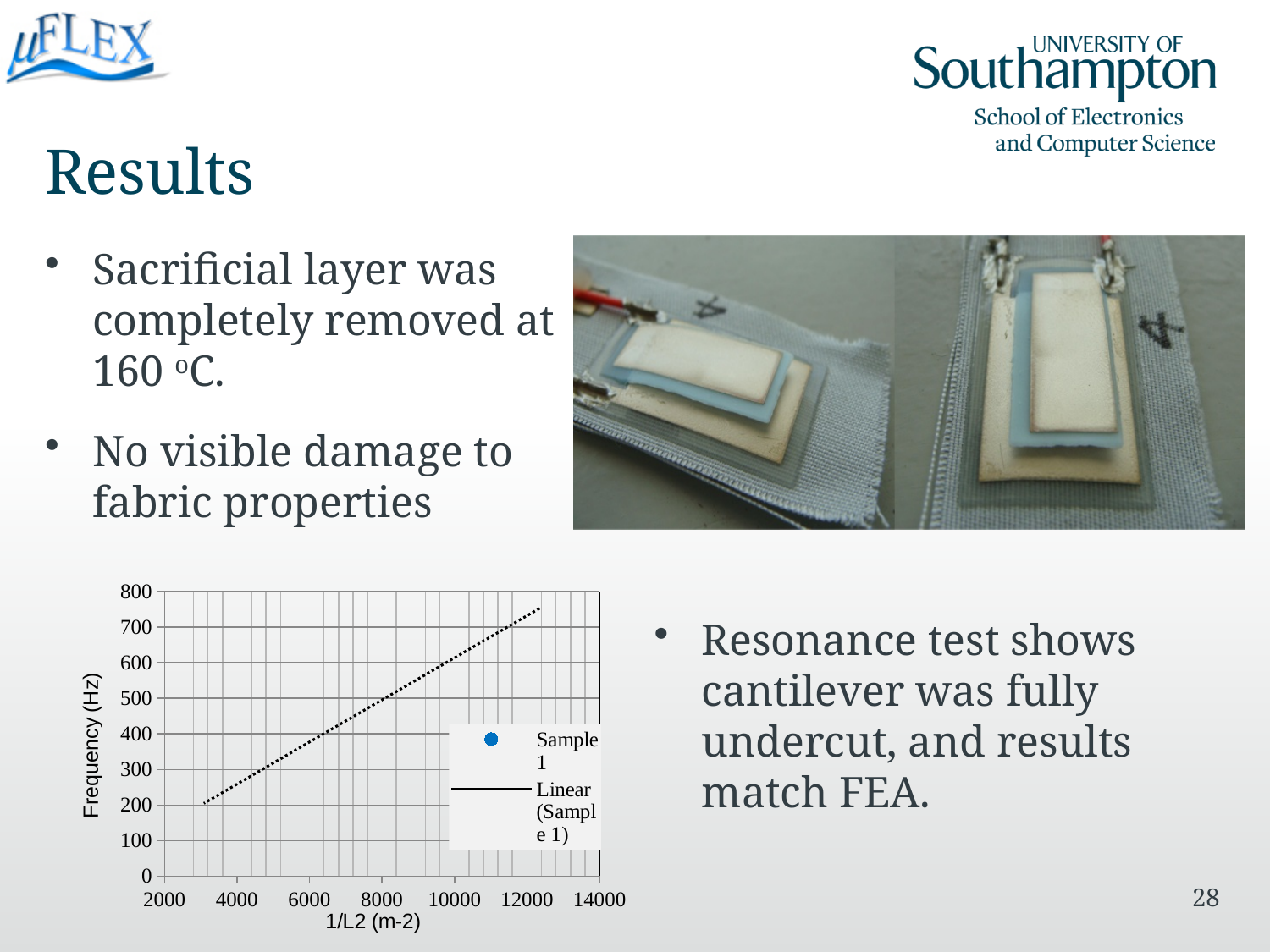
Is the frequency on the fitted line at 1/L2 = 12000 greater or less than 600? greater What is the label of the y axis of the chart? Frequency (Hz) Is the frequency on the fitted line at 1/L2 = 4000 greater or less than 400? less What is the label of the x axis of the chart? 1/L2 (m-2) Is the frequency on the fitted line at 1/L2 = 6000 greater or less than 500? less Does the frequency rise or fall as 1/L2 increases along the x axis? rise How many entries does the chart's legend list? 2 What kind of chart is shown on the slide? scatter chart